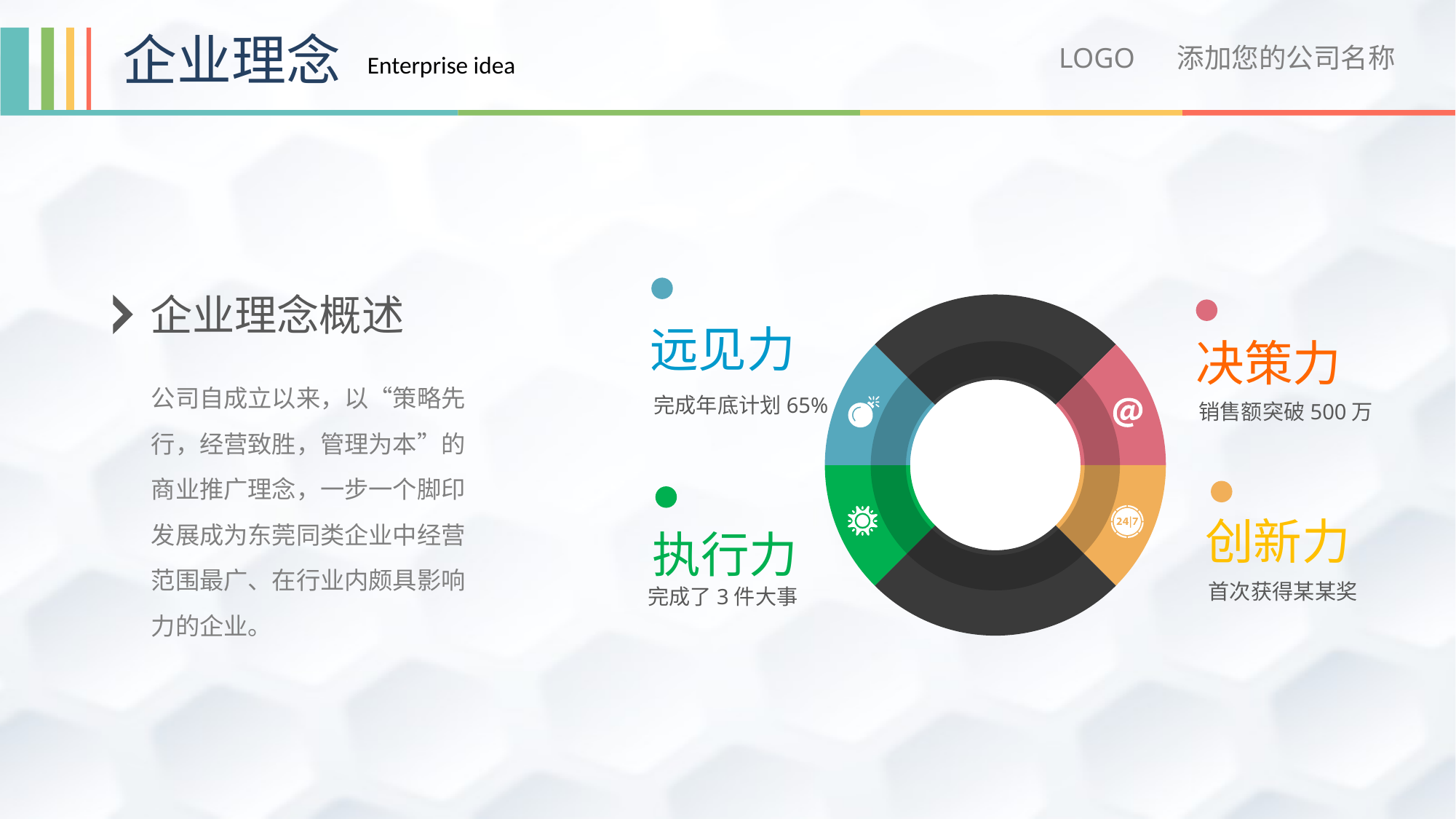
In the ring diagram, what text is shown under the label 决策力? 销售额突破 500 万 In the ring diagram, what text is shown under the label 创新力? 首次获得某某奖 In the ring diagram, what text is shown under the label 执行力? 完成了 3 件大事 Which label in the ring diagram is shown in green? 执行力 Which label in the ring diagram is shown in blue? 远见力 In the ring diagram, what text is shown under the label 远见力? 完成年底计划 65%